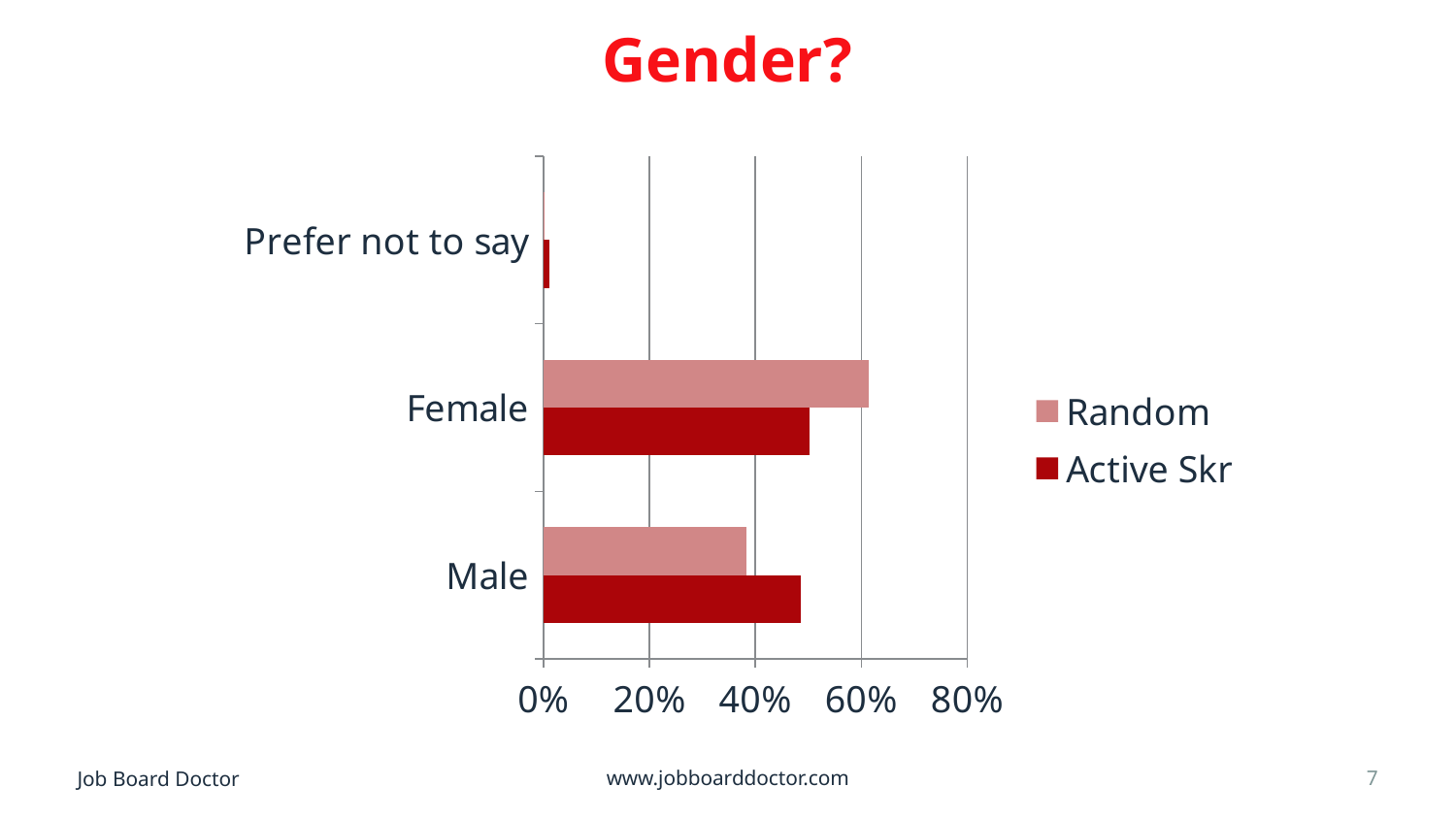
Which category has the lowest value for the Active Skr series? Prefer not to say What is the title of the chart? Gender? Which series is shown in the darker red colour in the legend? Active Skr How many categories are shown on the chart? 3 Which category has the lowest value for the Random series? Prefer not to say Is the Random value for Female greater or less than 40%? greater How many series does the legend list? 2 Which category has the highest value for the Random series? Female For the Male category, which series has the larger value, Random or Active Skr? Active Skr Is the Active Skr value for Female greater or less than 60%? less For the Female category, which series has the larger value, Random or Active Skr? Random What kind of chart is shown on the slide? bar chart